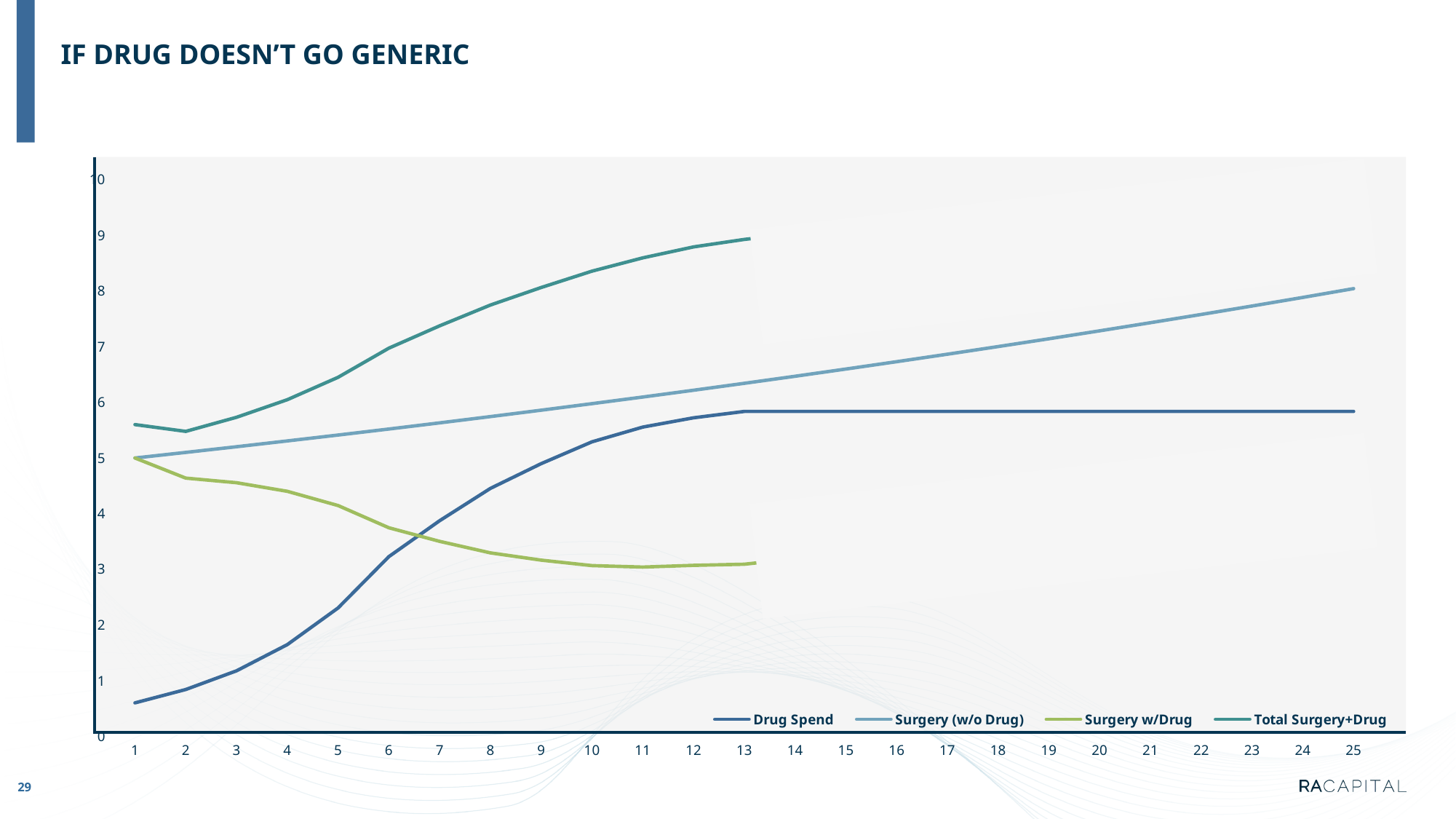
Is the value of Drug Spend at x = 25 greater or less than 6? less What is the value of Surgery (w/o Drug) at x = 1? 5 Is the value of Drug Spend at x = 1 greater or less than 1? less How many points are labelled on the x axis? 25 Is the value of Total Surgery+Drug at x = 13 greater or less than 8? greater What kind of chart is shown on the slide? line chart What is the title of the slide? IF DRUG DOESN'T GO GENERIC At x = 25, which is higher: Surgery (w/o Drug) or Drug Spend? Surgery (w/o Drug) How many series does the legend list? 4 Does the Surgery w/Drug line rise or fall from x = 1 to x = 13? fall Does the Drug Spend line rise or fall from x = 1 to x = 13? rise